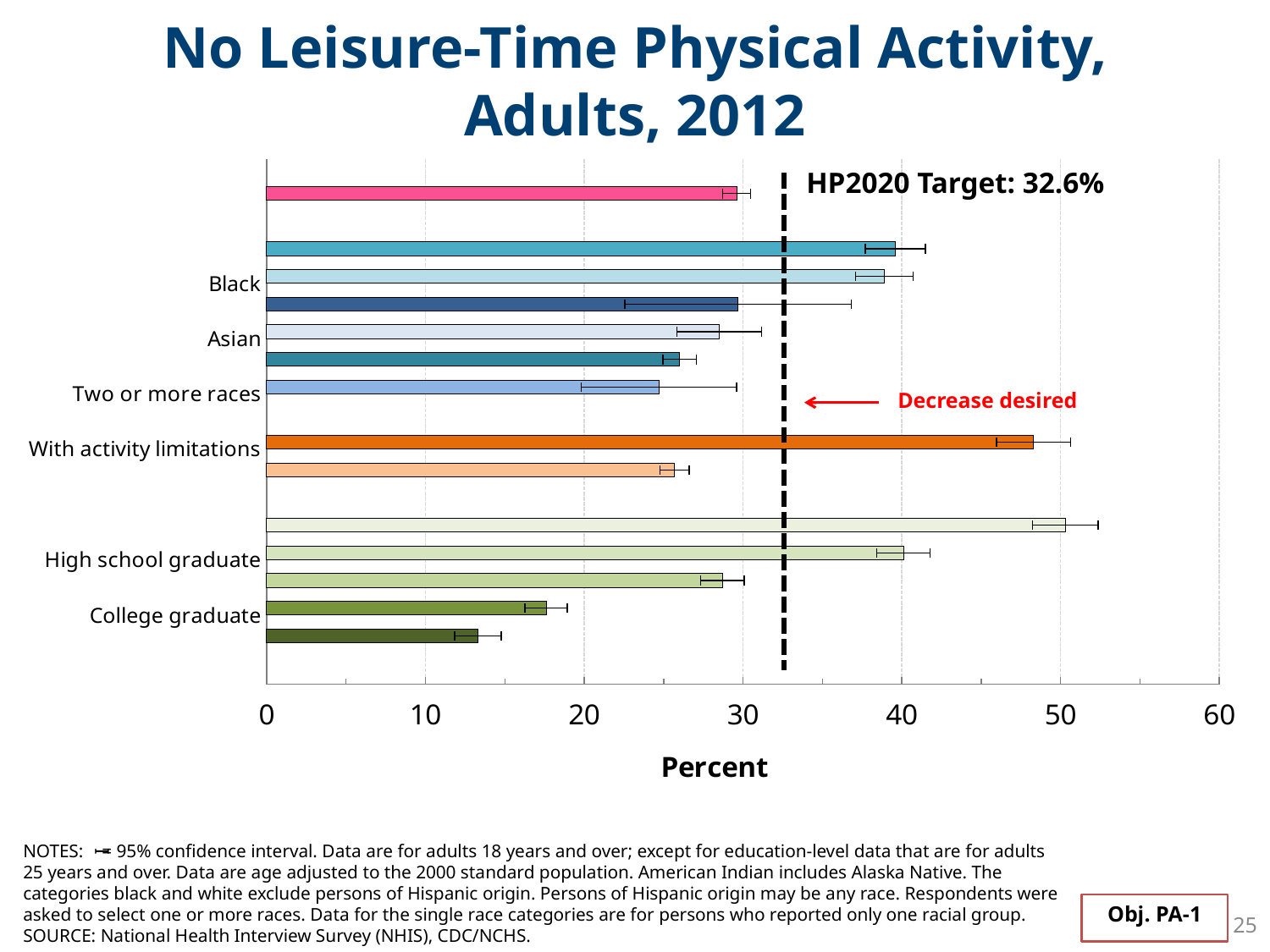
Is the value for Two or more races greater or less than 30? less What is the HP2020 Target value shown on the chart? 32.6% Is the value for College graduate greater or less than 20? less What is the label of the x axis? Percent Is the value for High school graduate greater or less than 30? greater Which has a larger value, High school graduate or College graduate? High school graduate Which has a larger value, Black or Asian? Black What kind of chart is shown on the slide? bar chart Which has a larger value, With activity limitations or Two or more races? With activity limitations